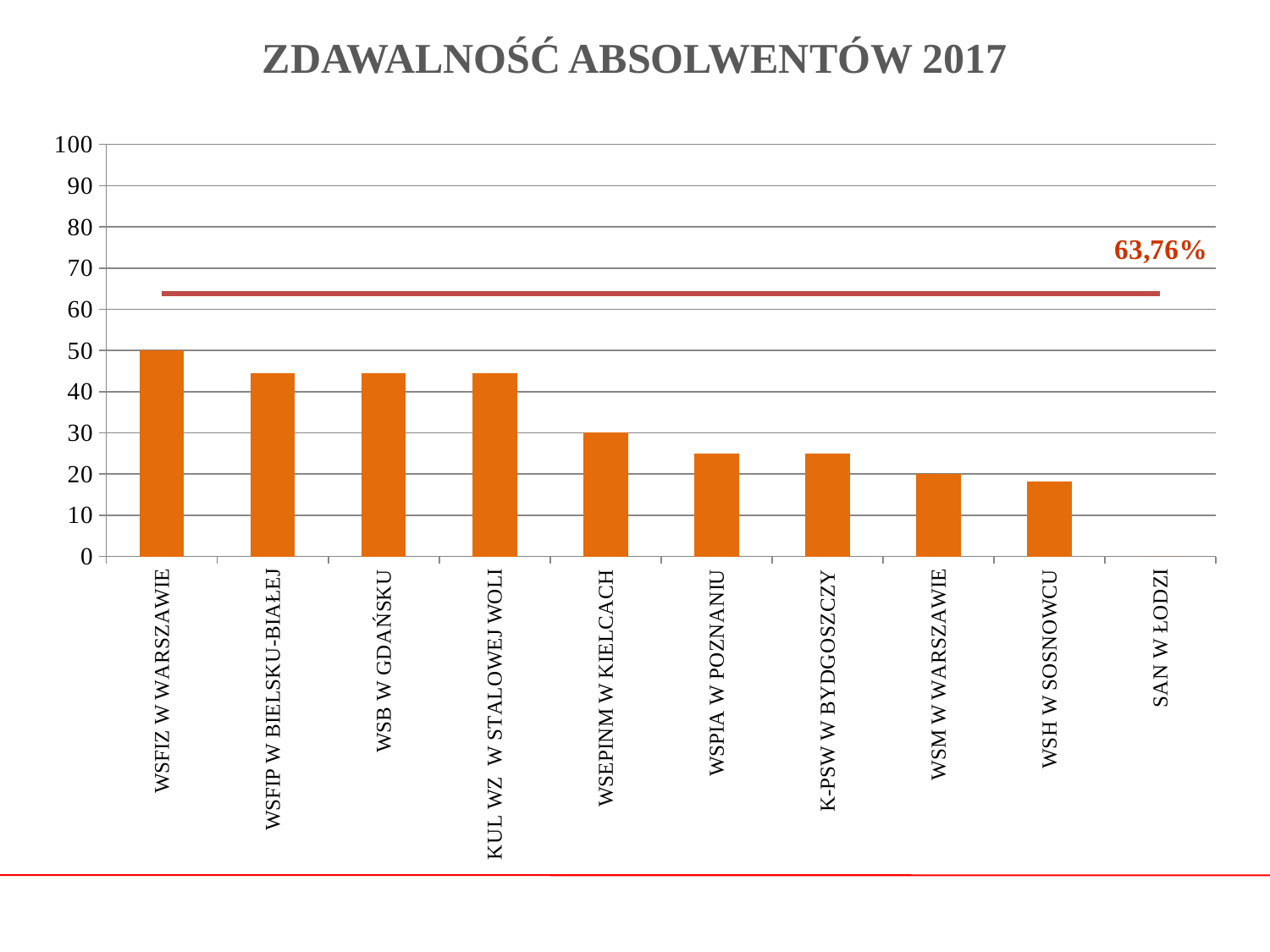
What value is printed next to the horizontal reference line? 63,76% Which institution has the lowest value? SAN W ŁODZI What type of chart is shown on the slide? bar chart Is the value for WSFIP W BIELSKU-BIAŁEJ greater or less than 40? greater Is the value for WSFIZ W WARSZAWIE greater or less than the 63,76% reference line? less Which institution has the highest bar? WSFIZ W WARSZAWIE What is the title of the chart? ZDAWALNOŚĆ ABSOLWENTÓW 2017 Is the value for WSH W SOSNOWCU greater or less than 20? less How many categories (institutions) are shown on the x axis? 10 Which is larger, the value for WSB W GDAŃSKU or the value for WSEPINM W KIELCACH? WSB W GDAŃSKU Do the bar values generally rise or fall from left to right along the x axis? fall Is the value for WSPIA W POZNANIU greater or less than 30? less